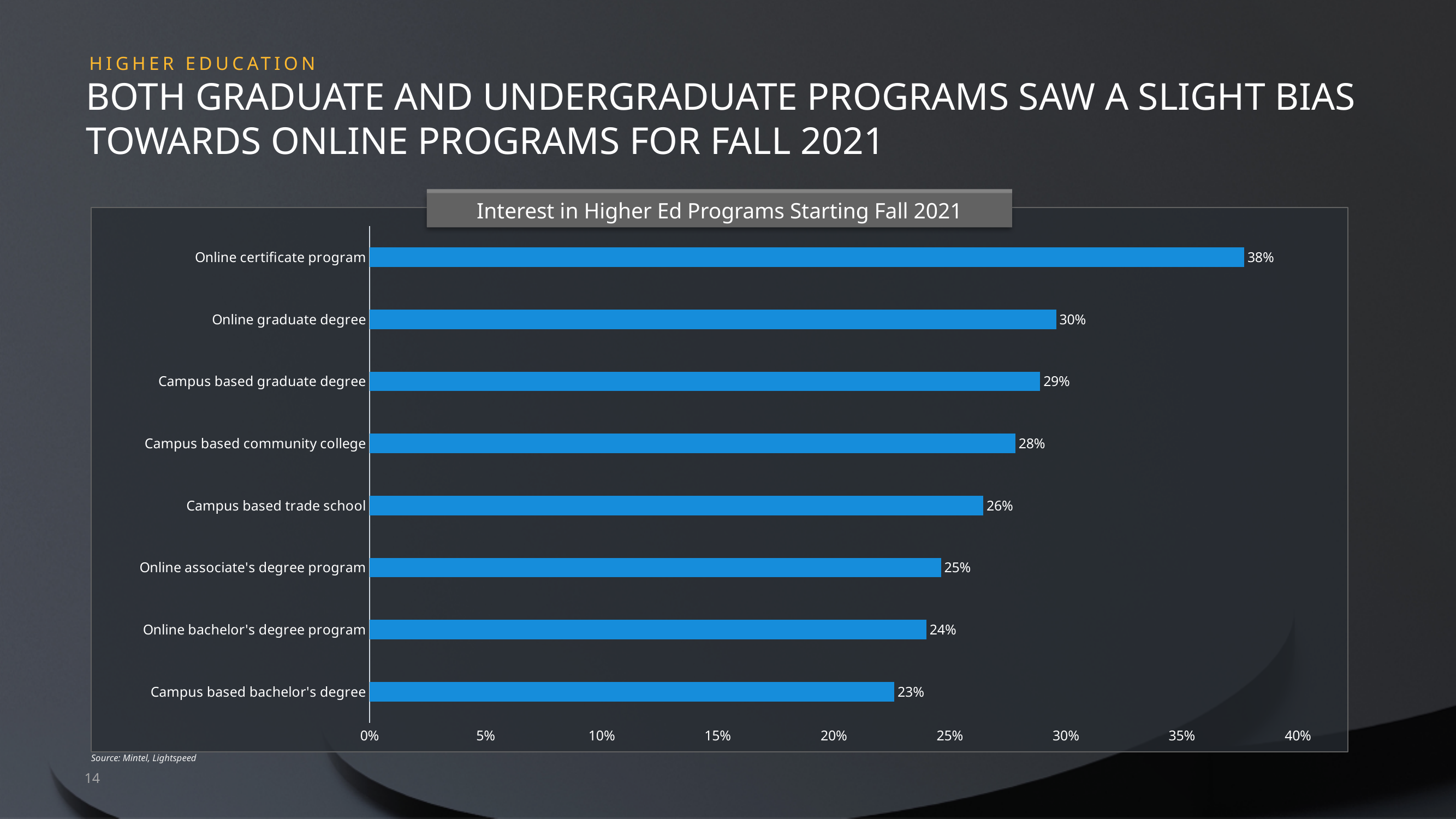
Which category has the lowest value? Campus based bachelor's degree What is the value for Online certificate program? 38% Which category has the highest value? Online certificate program What is the difference between Online certificate program and Online graduate degree? 8% What is the difference between Campus based community college and Campus based bachelor's degree? 5% What is the title of the chart? Interest in Higher Ed Programs Starting Fall 2021 Is the value for Campus based graduate degree greater or less than 25%? greater What is the value for Online bachelor's degree program? 24% What kind of chart is shown on the slide? Bar chart What is the value for Campus based trade school? 26% How many categories are shown in the chart? 8 Which is larger, Online graduate degree or Online associate's degree program? Online graduate degree